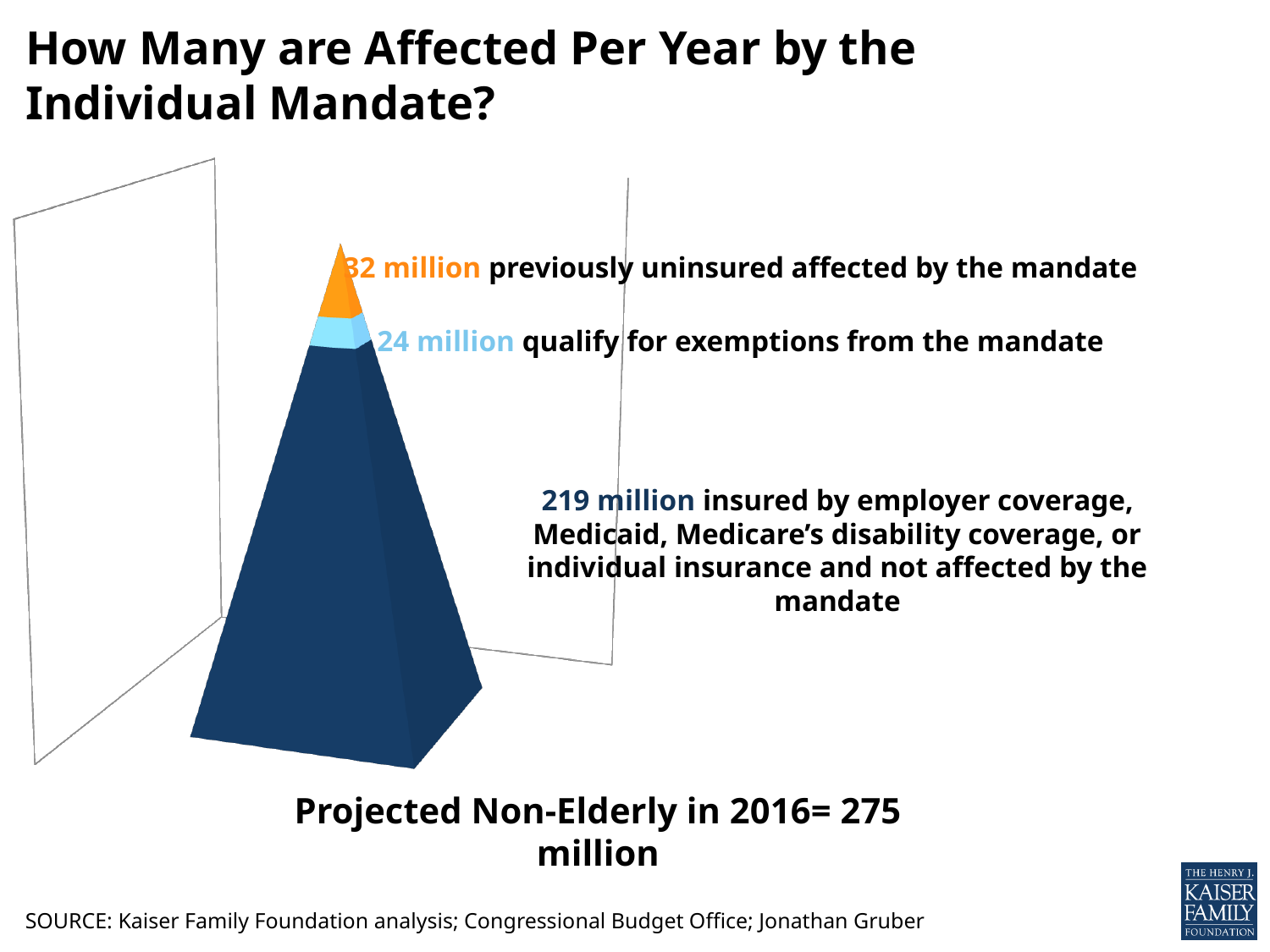
What is the difference between the number not affected by the mandate (219 million) and the number who qualify for exemptions (24 million)? 195 million What colour is the segment representing the 24 million who qualify for exemptions? Light blue Which group is the largest segment of the pyramid? 219 million insured by employer coverage, Medicaid, Medicare's disability coverage, or individual insurance and not affected by the mandate How many previously uninsured people are affected by the mandate? 32 million Which group is the smallest segment of the pyramid? 24 million qualify for exemptions from the mandate What is the projected total non-elderly population in 2016 shown on the slide? 275 million How many people qualify for exemptions from the mandate? 24 million How many segments does the pyramid chart have? 3 What kind of chart is shown on the slide? Pyramid chart What is the difference between the number of previously uninsured affected by the mandate and the number who qualify for exemptions? 8 million How many people are projected to be insured by employer coverage, Medicaid, Medicare's disability coverage, or individual insurance and not affected by the mandate? 219 million Which is larger: the number who qualify for exemptions or the number of previously uninsured affected by the mandate? Previously uninsured affected by the mandate